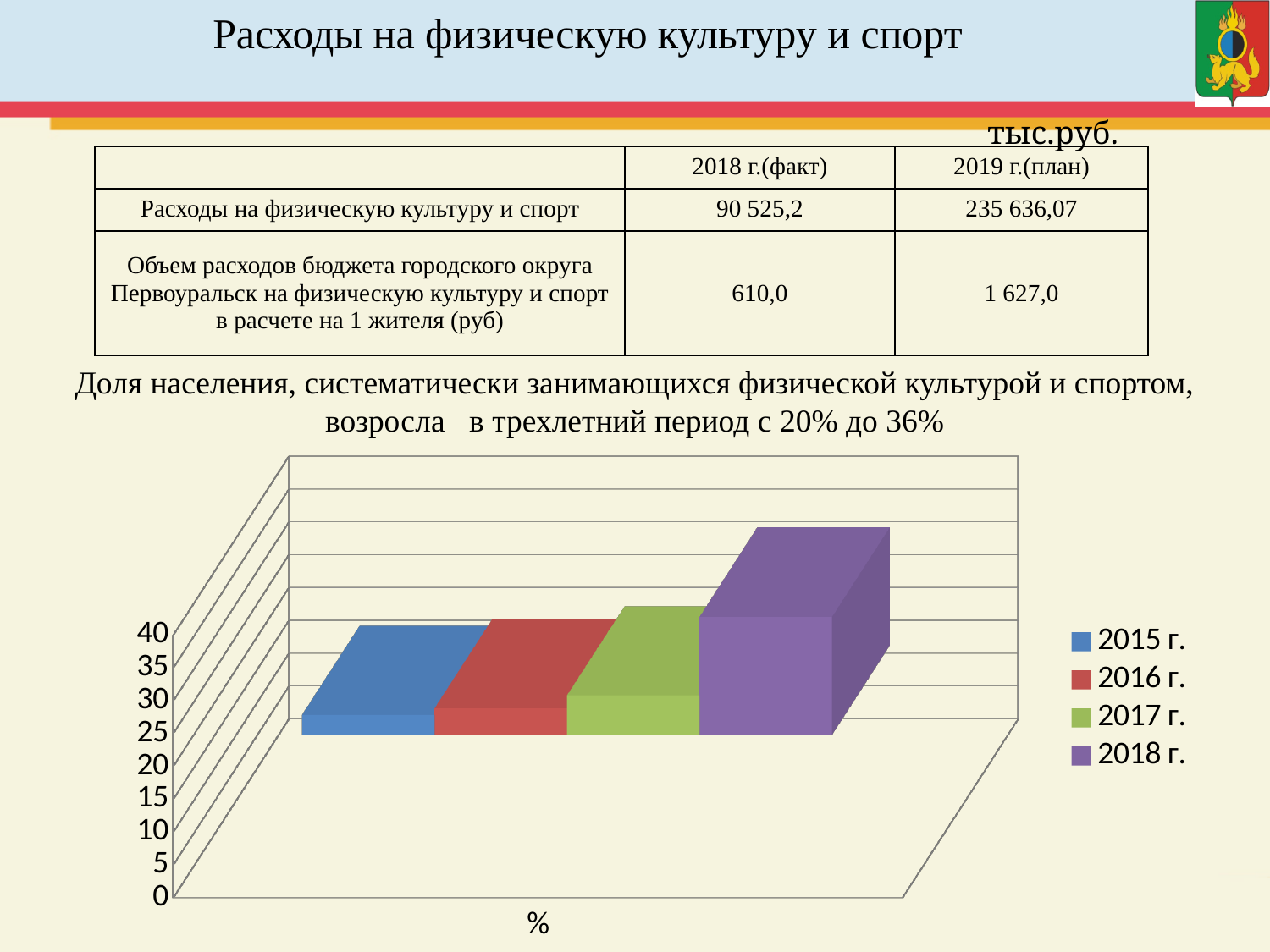
Which year has the highest bar in the chart? 2018 г. Do the bar values rise or fall from 2015 г. to 2018 г.? rise Which is larger in the chart, the bar for 2017 г. or the bar for 2018 г.? 2018 г. What kind of chart is shown on the slide? bar chart Which is larger in the chart, the bar for 2018 г. or the bar for 2015 г.? 2018 г. How many series does the chart legend list? 4 How many bars are plotted in the chart? 4 What is the maximum value shown on the chart's vertical axis? 40 What unit label is shown below the chart's horizontal axis? %